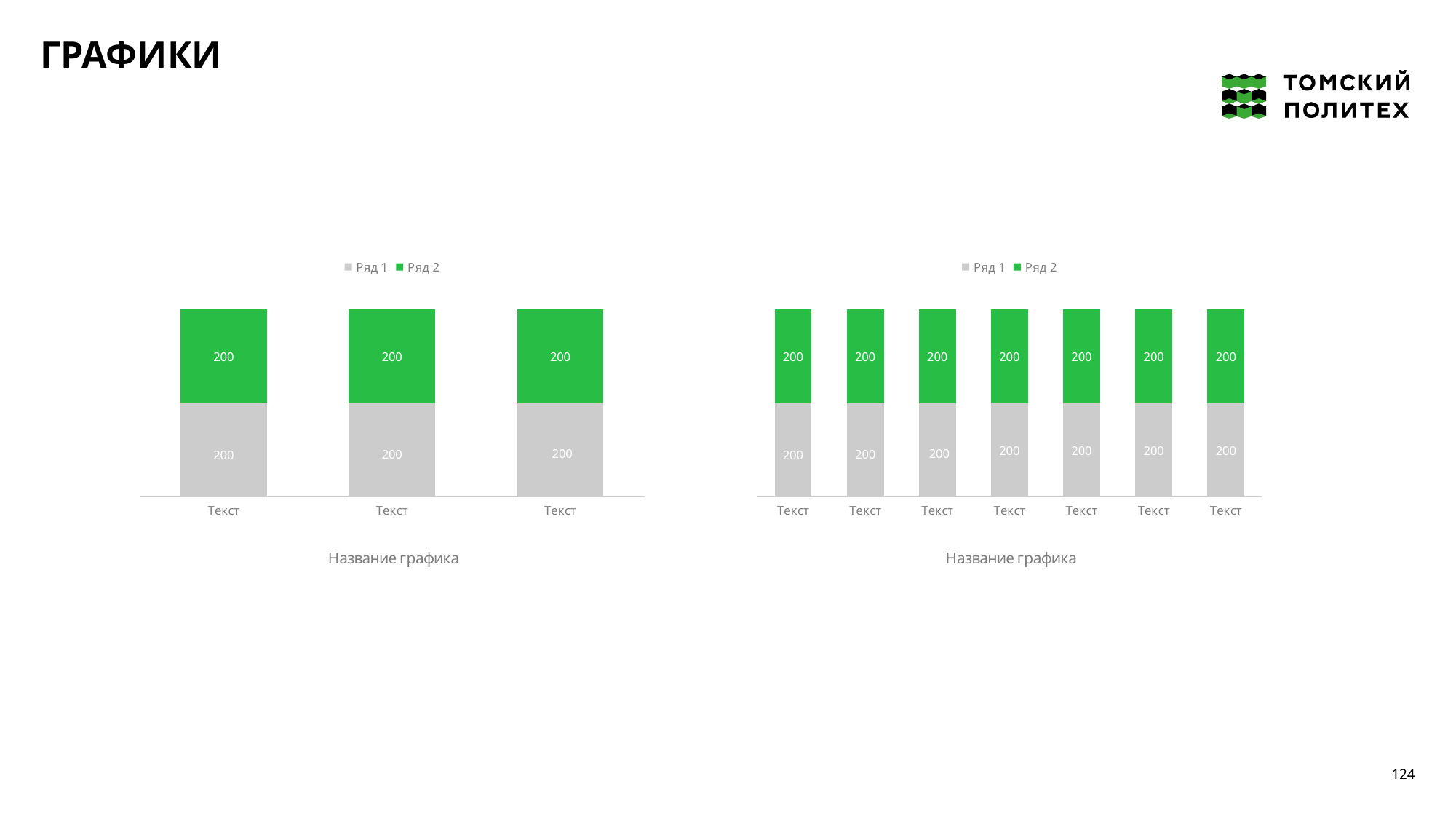
In the right chart, what is the value of Ряд 1 in the last bar? 200 In the left chart, what is the total of the first stacked bar? 400 In the left chart, what is the value of Ряд 2 in the first bar? 200 In the left chart, what is the difference between Ряд 1 and Ряд 2 in the second bar? 0 In the right chart, do the Ряд 2 values rise, fall or stay flat across the bars? Stay flat Which colour represents Ряд 2 in the left chart's legend? Green What kind of chart is the left chart on the slide? Stacked bar chart How many series does the legend of the left chart list? 2 In the right chart, what is the total of the fourth stacked bar? 400 How many bars does the left chart have? 3 How many bars does the right chart have? 7 How many series does the legend of the right chart list? 2